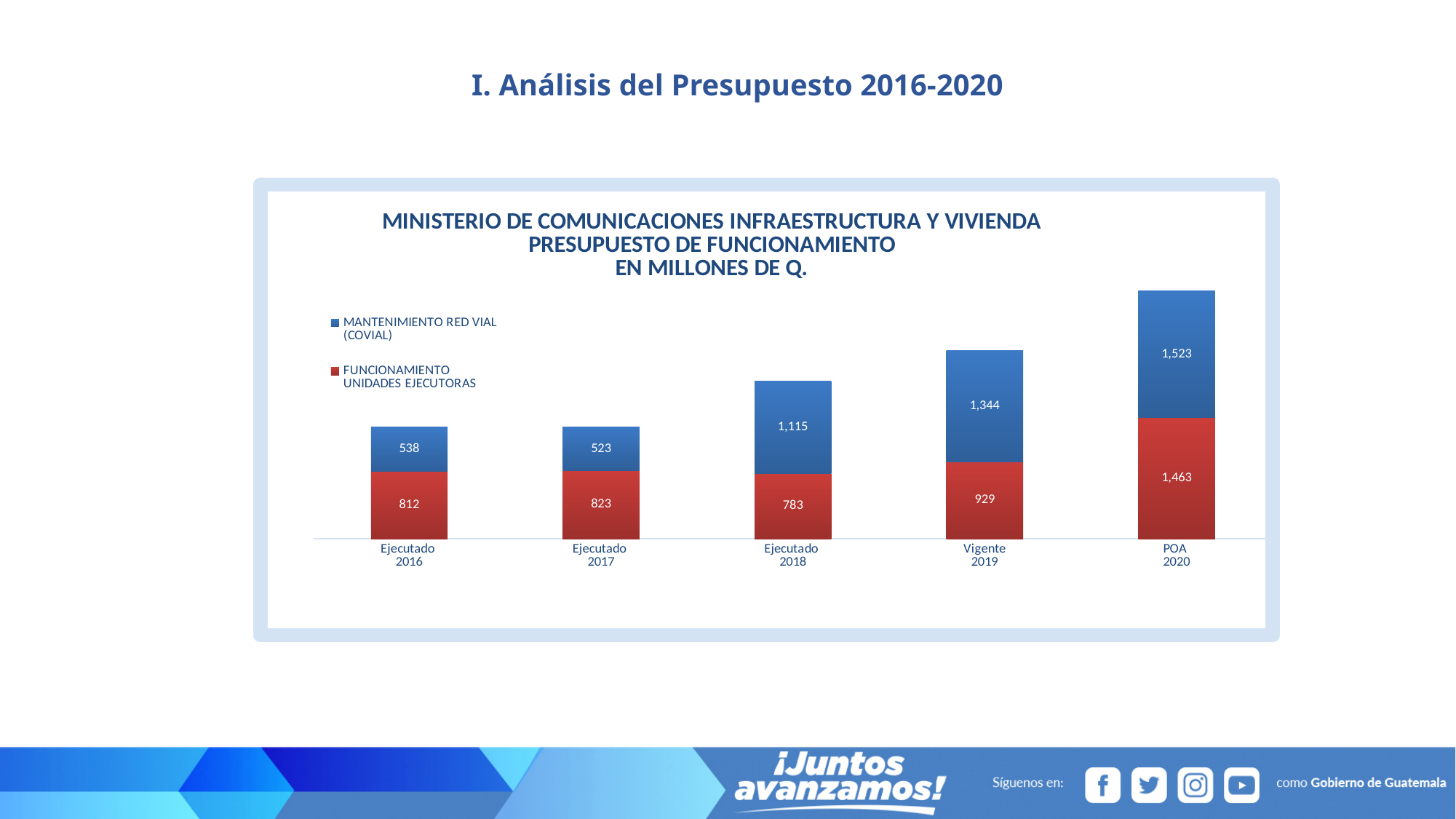
Which is larger in Ejecutado 2017: MANTENIMIENTO RED VIAL (COVIAL) or FUNCIONAMIENTO UNIDADES EJECUTORAS? FUNCIONAMIENTO UNIDADES EJECUTORAS What is the total of the stacked bar for Ejecutado 2016? 1,350 What is the value for MANTENIMIENTO RED VIAL (COVIAL) in Ejecutado 2018? 1,115 What is the total of the stacked bar for POA 2020? 2,986 How many categories are shown on the x axis? 5 Which category has the highest value for MANTENIMIENTO RED VIAL (COVIAL)? POA 2020 What is the value for FUNCIONAMIENTO UNIDADES EJECUTORAS in Vigente 2019? 929 What is the value for FUNCIONAMIENTO UNIDADES EJECUTORAS in POA 2020? 1,463 What kind of chart is shown on the slide? Stacked bar chart What is the difference between the MANTENIMIENTO RED VIAL (COVIAL) values for POA 2020 and Vigente 2019? 179 Which category has the lowest value for FUNCIONAMIENTO UNIDADES EJECUTORAS? Ejecutado 2018 How many series does the legend list? 2